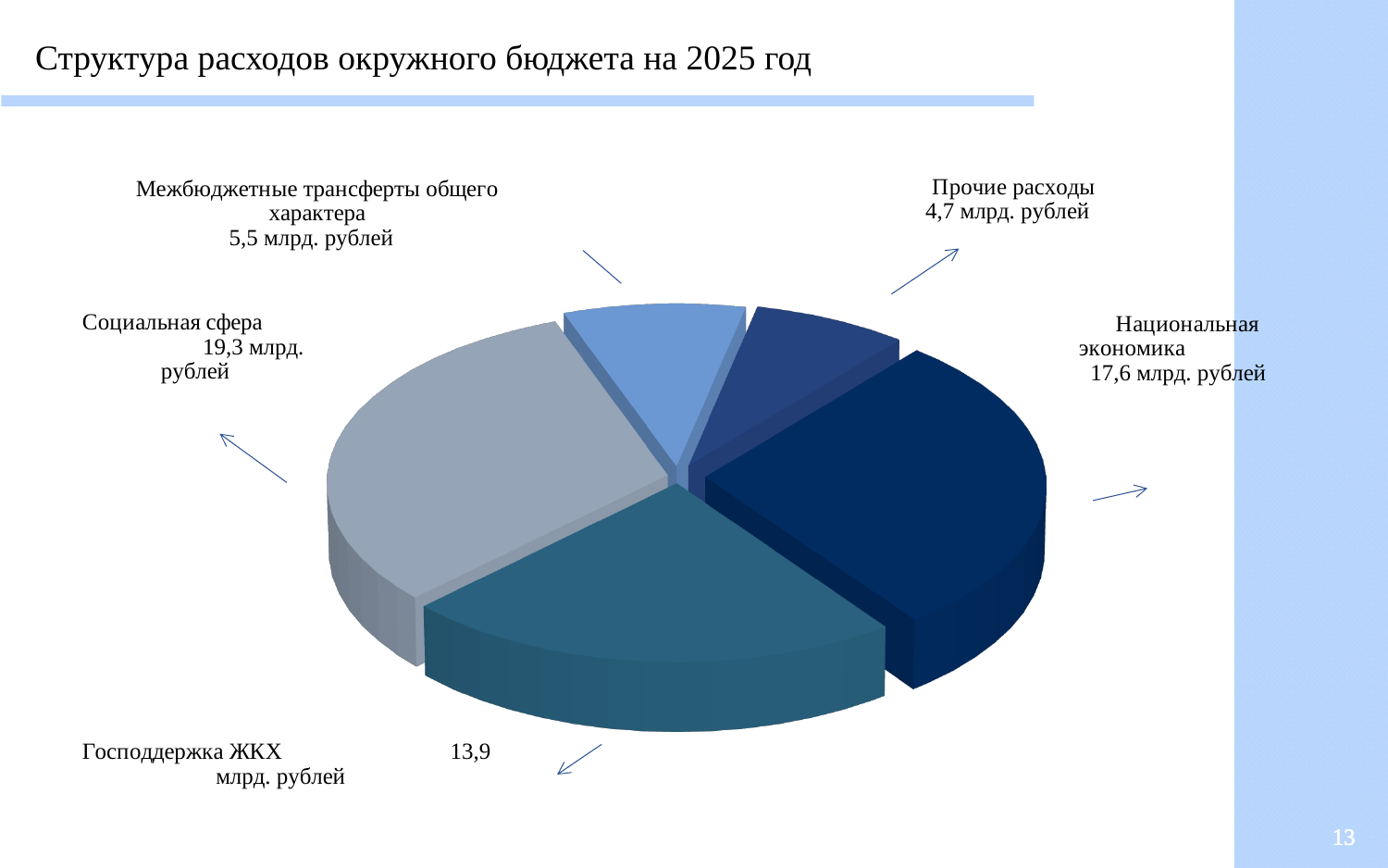
What is the value for Господдержка ЖКХ? 13,9 млрд. рублей What is the value for Национальная экономика? 17,6 млрд. рублей Which is larger, Национальная экономика or Господдержка ЖКХ? Национальная экономика What is the title of the chart on the slide? Структура расходов окружного бюджета на 2025 год Which category has the largest share of the pie? Социальная сфера What is the value for Социальная сфера? 19,3 млрд. рублей What is the total of all the values shown on the pie chart? 61,0 млрд. рублей What is the value for Межбюджетные трансферты общего характера? 5,5 млрд. рублей How many slices does the pie chart have? 5 Which category has the smallest share of the pie? Прочие расходы What kind of chart is shown on the slide? Pie chart What is the difference between Социальная сфера and Национальная экономика? 1,7 млрд. рублей